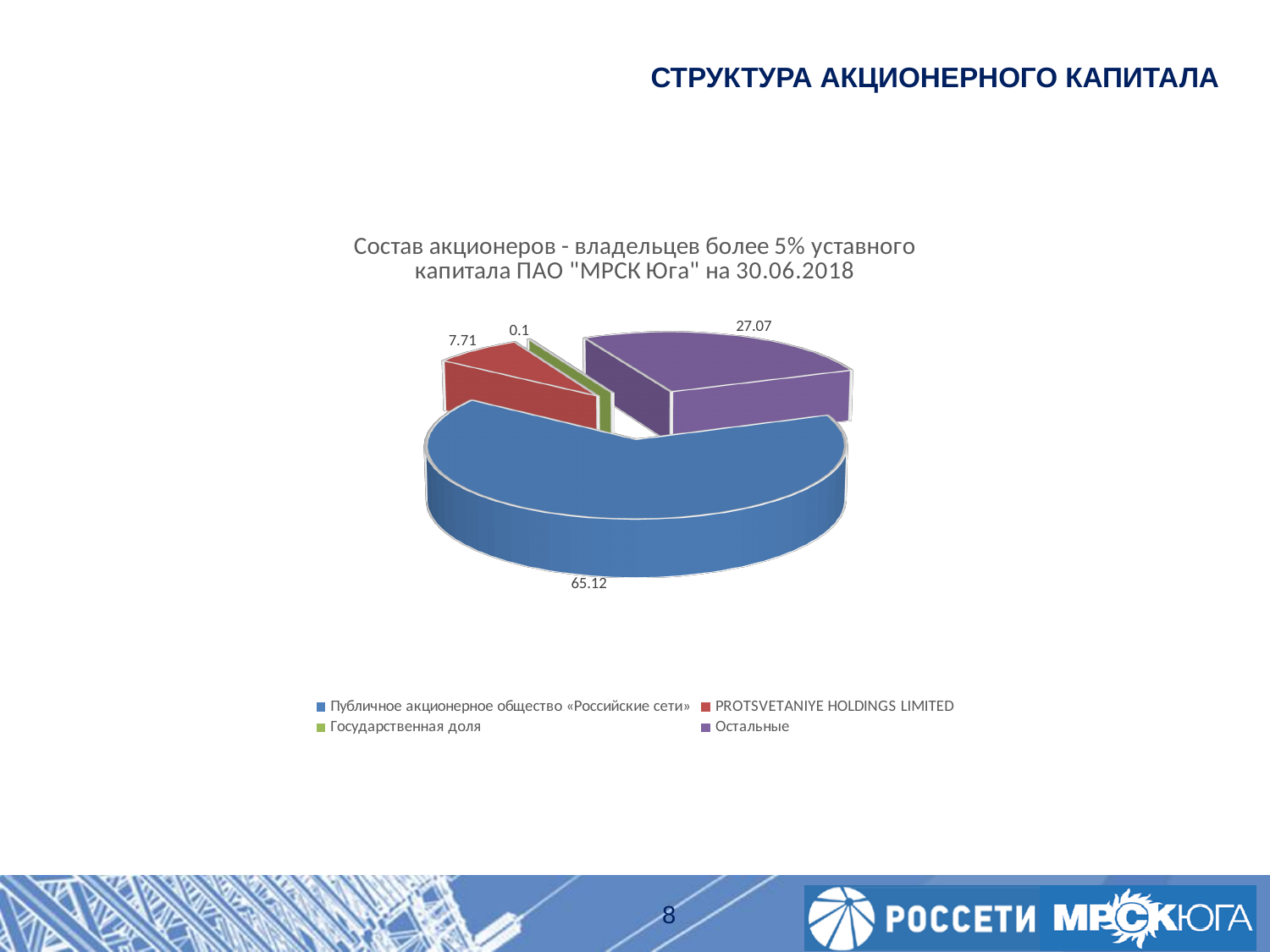
How many slices does the pie chart have? 4 Which category has the smallest slice of the pie? Государственная доля What is the value for Государственная доля? 0.1 What is the value for Публичное акционерное общество «Российские сети»? 65.12 Which category has the largest slice of the pie? Публичное акционерное общество «Российские сети» What kind of chart is shown on the slide? pie chart What is the value for PROTSVETANIYE HOLDINGS LIMITED? 7.71 What is the difference between the values for Остальные and PROTSVETANIYE HOLDINGS LIMITED? 19.36 What colour is the slice for Остальные? purple Which is larger, the value for Остальные or the value for PROTSVETANIYE HOLDINGS LIMITED? Остальные What is the title of the chart? Состав акционеров - владельцев более 5% уставного капитала ПАО "МРСК Юга" на 30.06.2018 What is the value for Остальные? 27.07